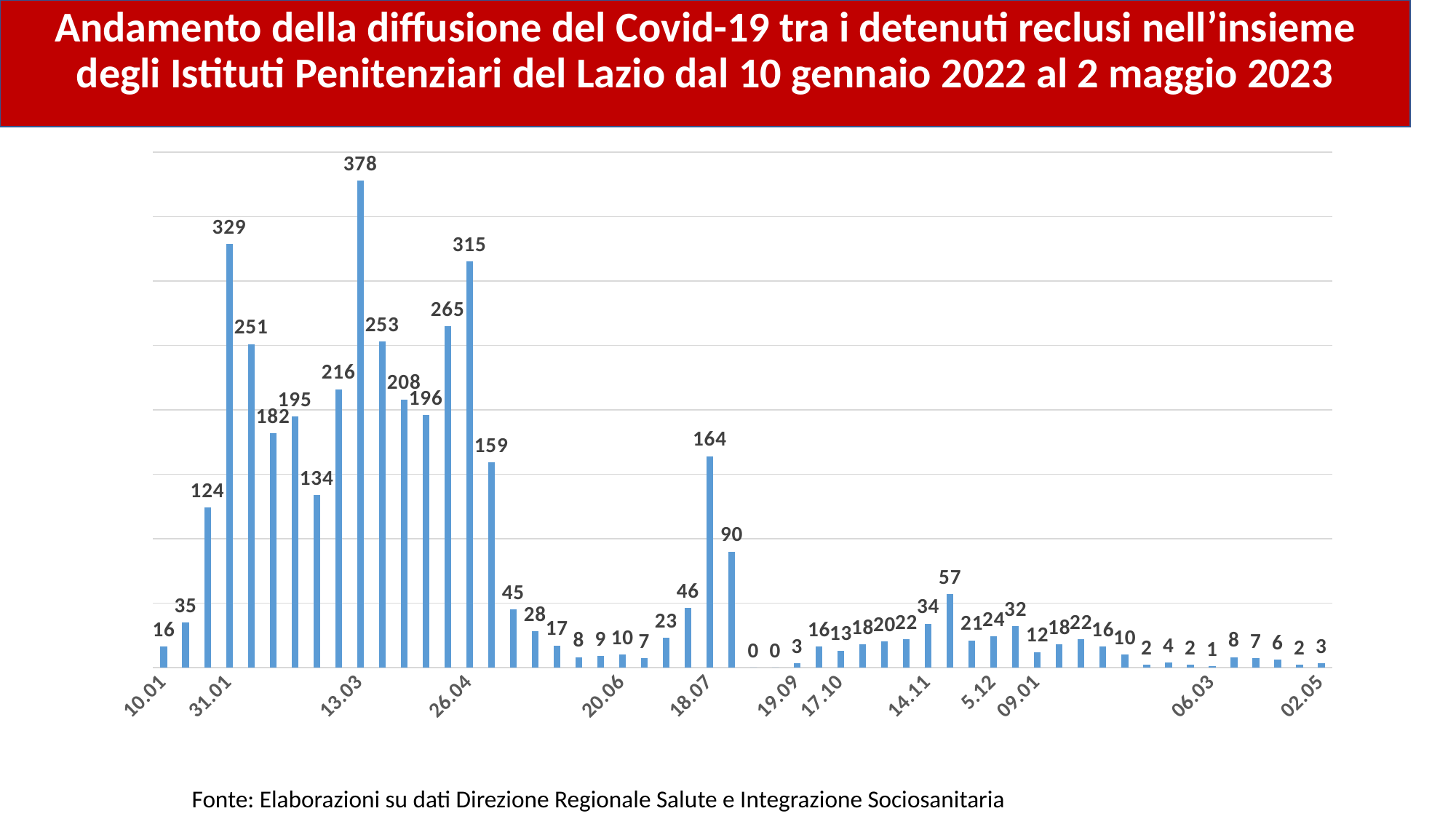
What is the difference between the bars labelled 164 and 90? 74 Is the value for the first date, 10.01, greater or less than the value for the last date, 02.05? Greater What colour are the bars in the chart? Blue What is the value for the first date, 10.01? 16 What is the source cited below the chart? Elaborazioni su dati Direzione Regionale Salute e Integrazione Sociosanitaria What is the lowest value shown in the chart? 0 What is the difference between the highest value (378) and the second highest value (329)? 49 What is the highest value shown in the chart? 378 Which is larger, the bar labelled 315 or the bar labelled 329? 329 What kind of chart is shown on the slide? Bar chart What is the value for the last date, 02.05? 3 Overall, do the values rise or fall from the left of the x axis to the right? Fall